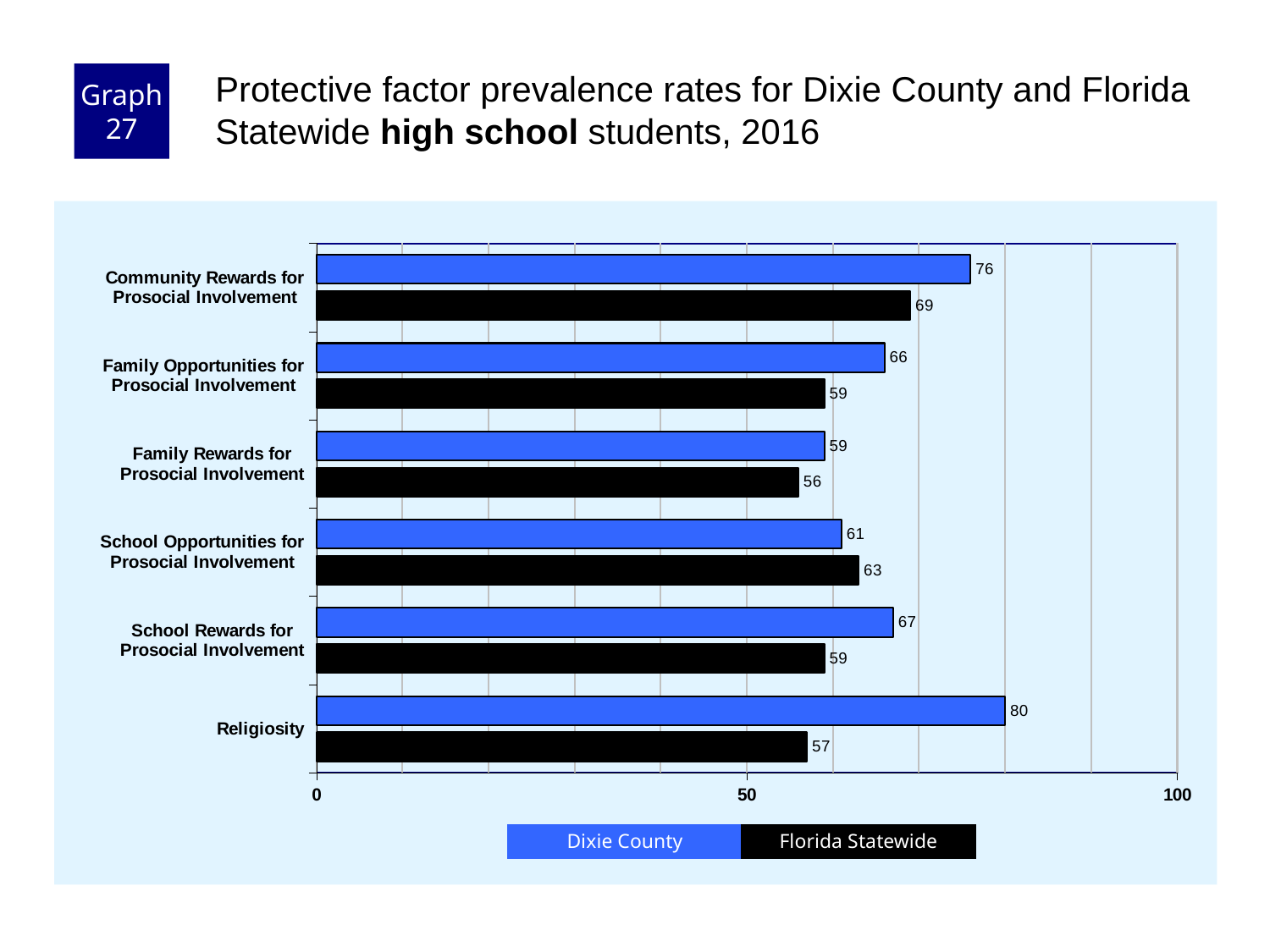
For School Opportunities for Prosocial Involvement, which is larger: the Dixie County value or the Florida Statewide value? Florida Statewide Which protective factor has the highest Dixie County value? Religiosity Which protective factor has the lowest Florida Statewide value? Family Rewards for Prosocial Involvement What is the difference between the Dixie County and Florida Statewide values for Religiosity? 23 How many protective factors are shown on the chart? 6 What is the Dixie County value for School Opportunities for Prosocial Involvement? 61 What is the Dixie County value for Religiosity? 80 Is the Dixie County value for Community Rewards for Prosocial Involvement greater or less than 50? greater What is the Florida Statewide value for Community Rewards for Prosocial Involvement? 69 How many series does the legend list? 2 Which colour represents Florida Statewide in the chart? black What kind of chart is shown on the slide? bar chart